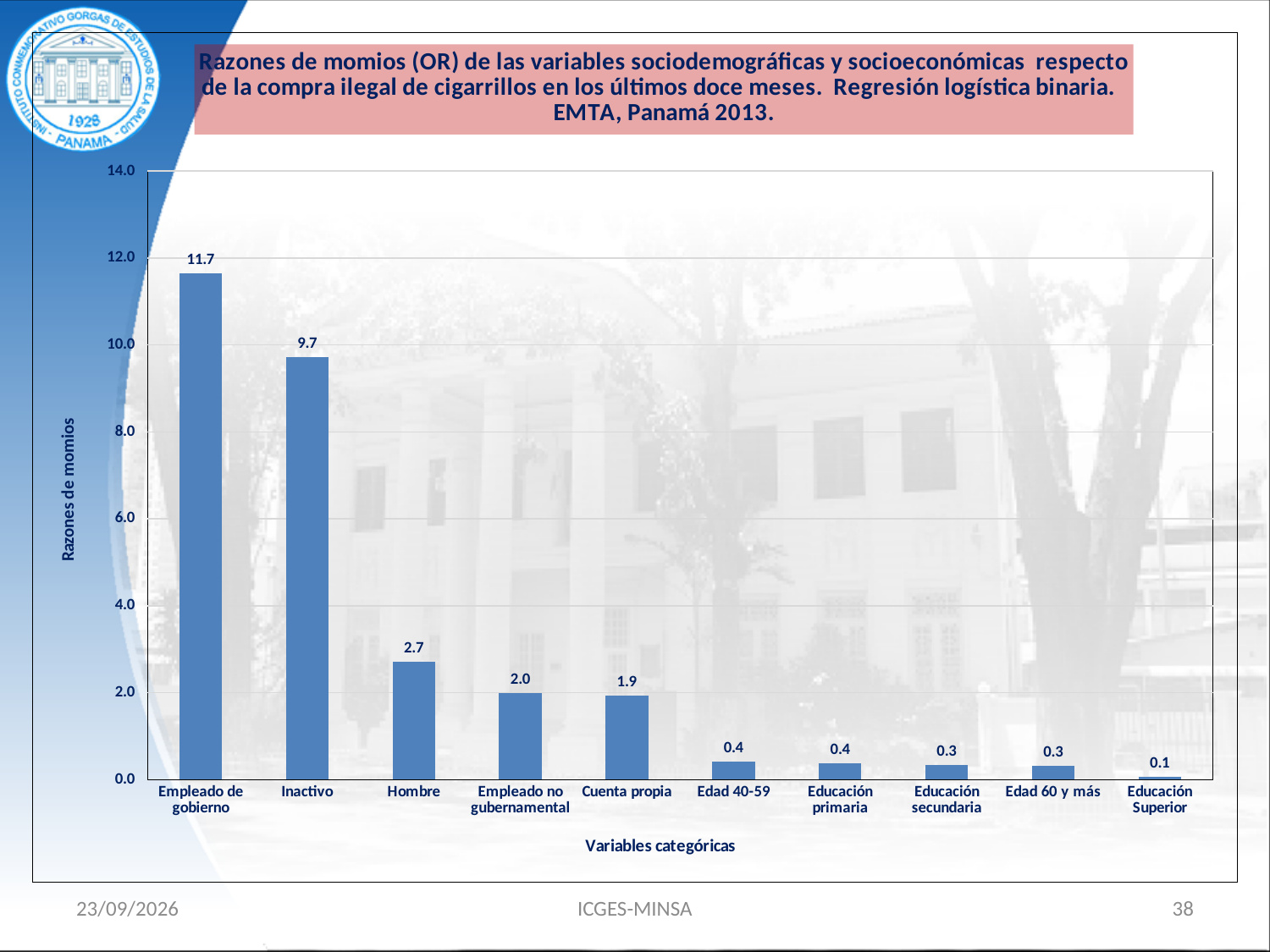
What is the difference between the values for 'Empleado de gobierno' and 'Inactivo'? 2.0 What kind of chart is shown on the slide? Bar chart What is the value shown for 'Hombre'? 2.7 What is the value shown for 'Inactivo'? 9.7 How many categories are shown on the x axis? 10 Which is larger, the value for 'Empleado no gubernamental' or for 'Cuenta propia'? Empleado no gubernamental Is the value for 'Inactivo' greater or less than 10.0? less What is the odds ratio (razón de momios) for 'Empleado de gobierno'? 11.7 Which category has the highest odds ratio? Empleado de gobierno What is the value shown for 'Educación Superior'? 0.1 What is the label of the y axis? Razones de momios Which category has the lowest odds ratio? Educación Superior